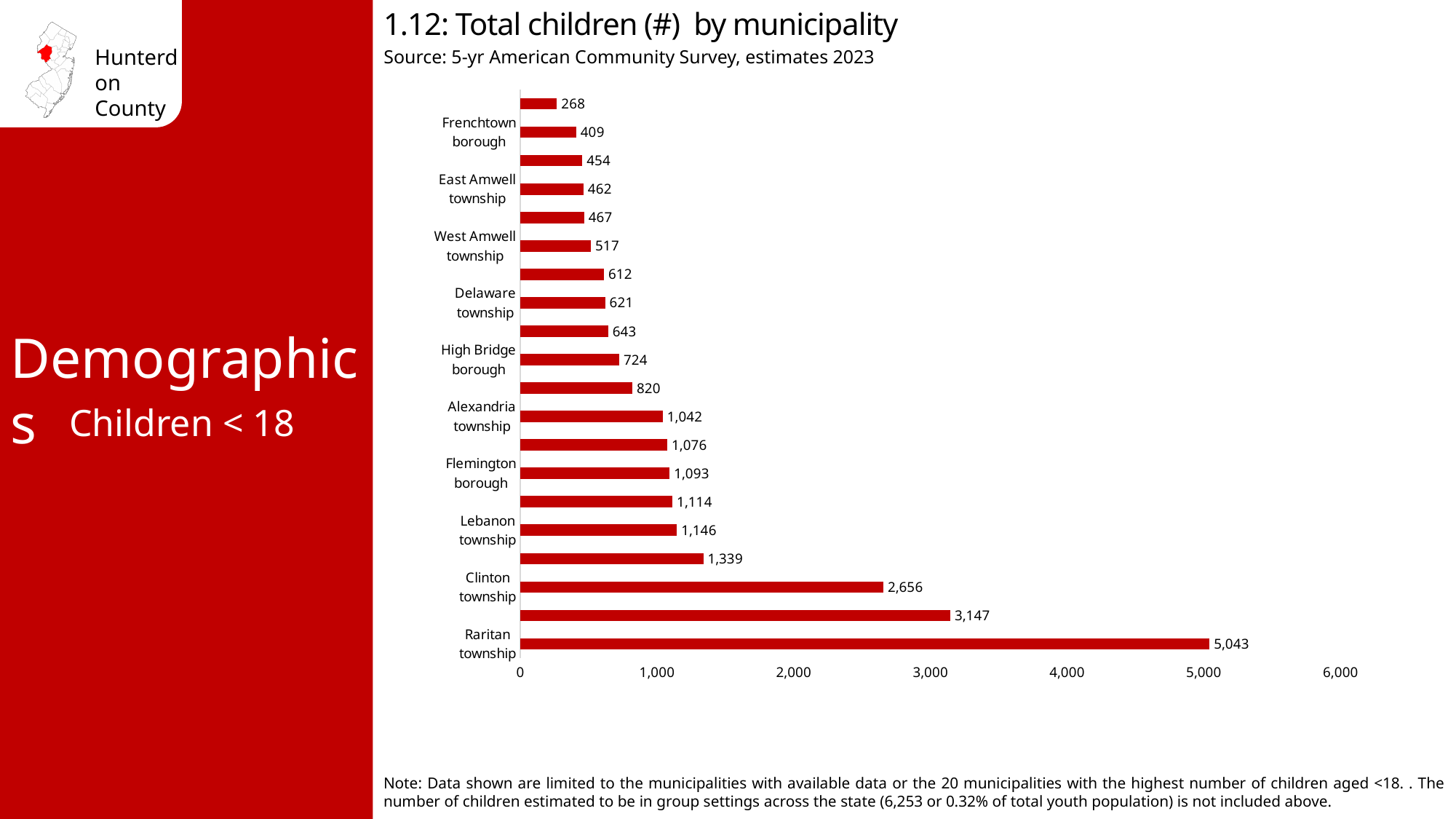
Is the value for Clinton township greater or less than 2,000? greater What is the total number of children for Clinton township? 2,656 Which has more children, Lebanon township or Flemington borough? Lebanon township How many bars are plotted in the chart? 20 What is the difference in total children between Raritan township and Clinton township? 2,387 What is the total number of children for High Bridge borough? 724 Which labeled municipality has the highest number of children? Raritan township What is the total number of children for Raritan township? 5,043 What is the total number of children for Frenchtown borough? 409 What is the highest value printed on the horizontal axis? 6,000 What is the title of the chart? 1.12: Total children (#) by municipality What kind of chart is shown on the slide? bar chart